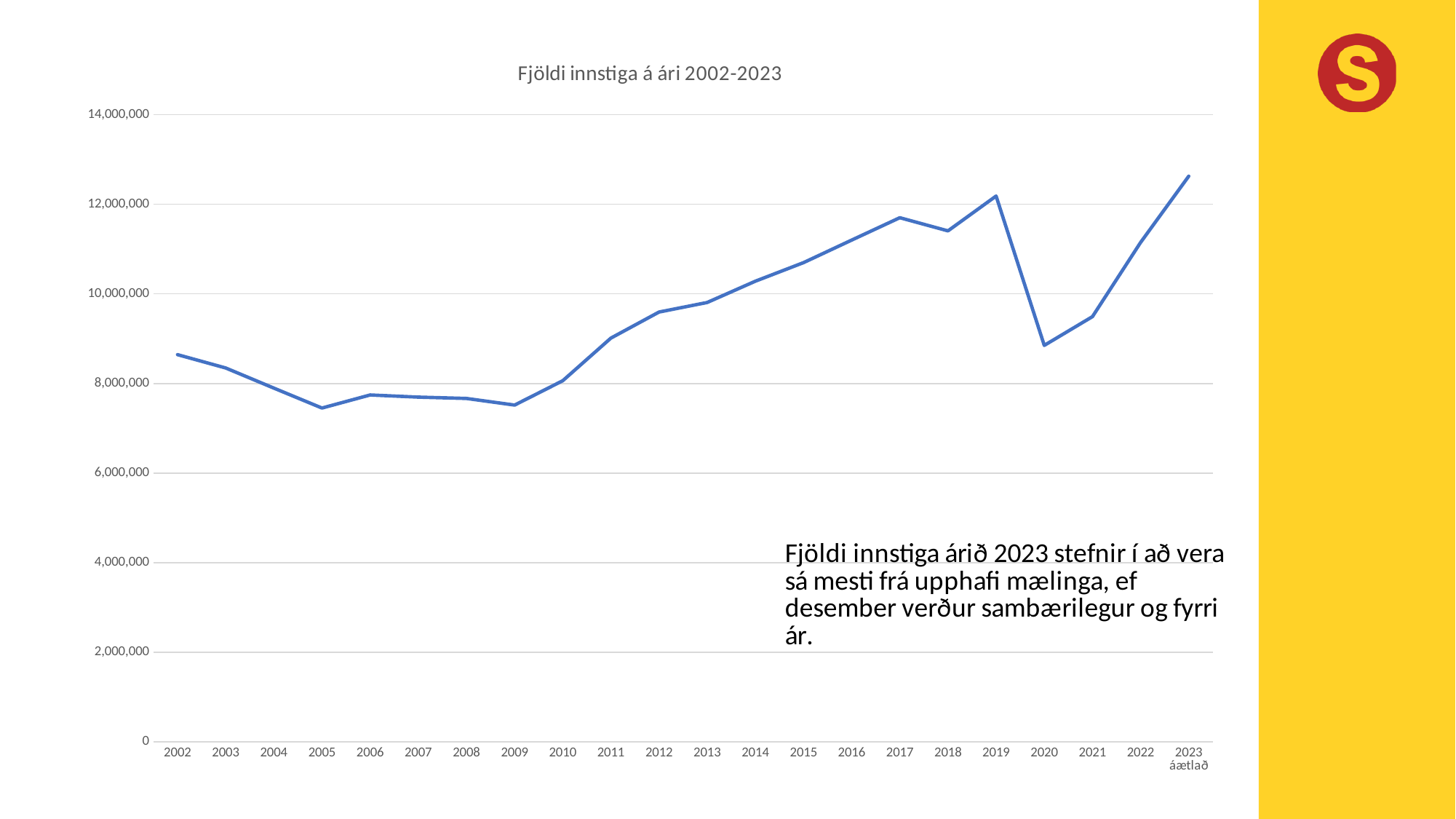
Which year has the highest value on the chart? 2023 áætlað How many years are plotted along the x axis of the chart? 22 Is the value for 2020 greater or less than 10,000,000? less Is the value for 2017 greater or less than 10,000,000? greater Which is larger, the value for 2019 or the value for 2020? 2019 Do the values rise or fall from 2009 to 2017? rise Is the value for 2023 áætlað greater or less than 12,000,000? greater Which is larger, the value for 2002 or the value for 2005? 2002 What kind of chart is shown on the slide? line chart What is the title of the chart? Fjöldi innstiga á ári 2002-2023 Do the values rise or fall from 2002 to 2005? fall